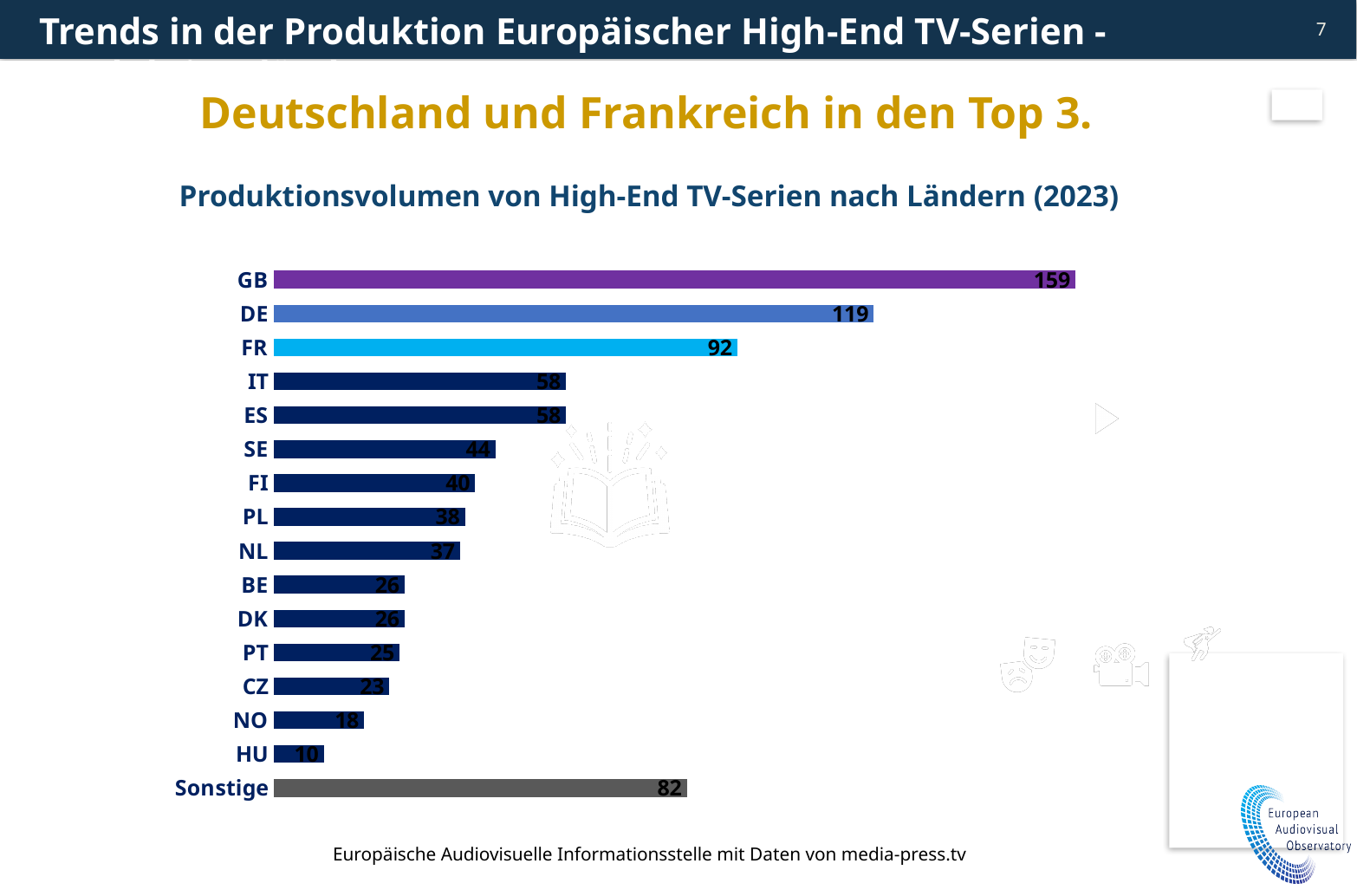
What is the value shown for FR? 92 What is the value shown for NO? 18 What is the difference between the values for GB and DE? 40 Which is larger, the value for SE or the value for FI? SE What kind of chart is shown on the slide? Bar chart Which country has the lowest production volume among the named countries? HU How many bars are shown in the chart? 16 What is the title of the chart? Produktionsvolumen von High-End TV-Serien nach Ländern (2023) What is the value shown for Sonstige? 82 What is the production volume value shown for GB? 159 Which country has the highest production volume? GB What is the difference between the values for DE and FR? 27